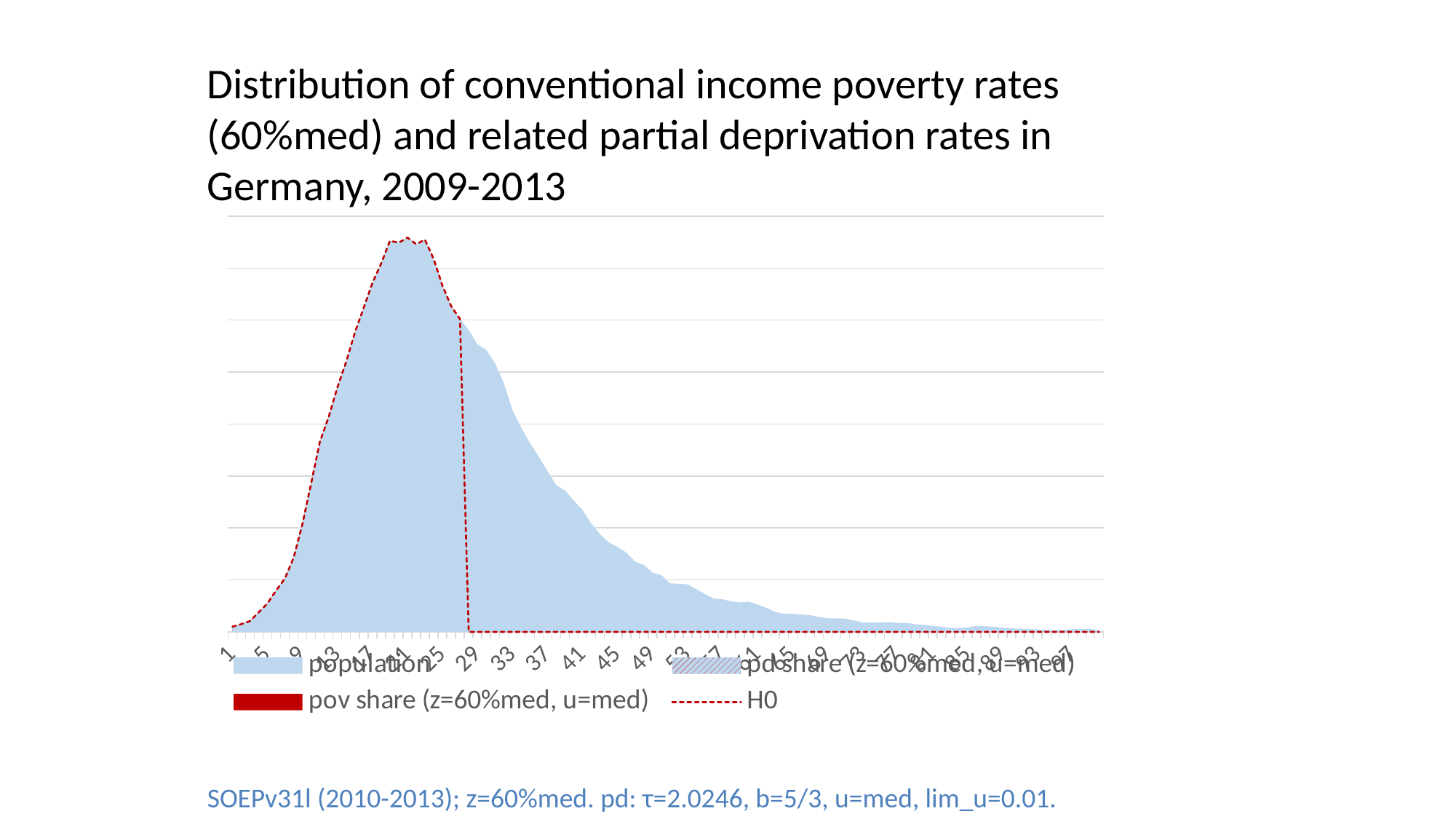
Is the H0 value at x = 17 greater or less than the H0 value at x = 41? Greater Does the population series rise or fall along the x axis between 1 and 21? Rise Is the population value at x = 21 greater or less than the population value at x = 49? Greater Which series is shown as the light blue filled area? population What kind of chart is shown on the slide? Area chart Does the population series rise or fall along the x axis after its peak near 21? Fall What is the name of the series drawn as a dashed red line? H0 How many series does the legend list? 4 Around which x-axis label does the H0 dashed line drop sharply to the baseline? 29